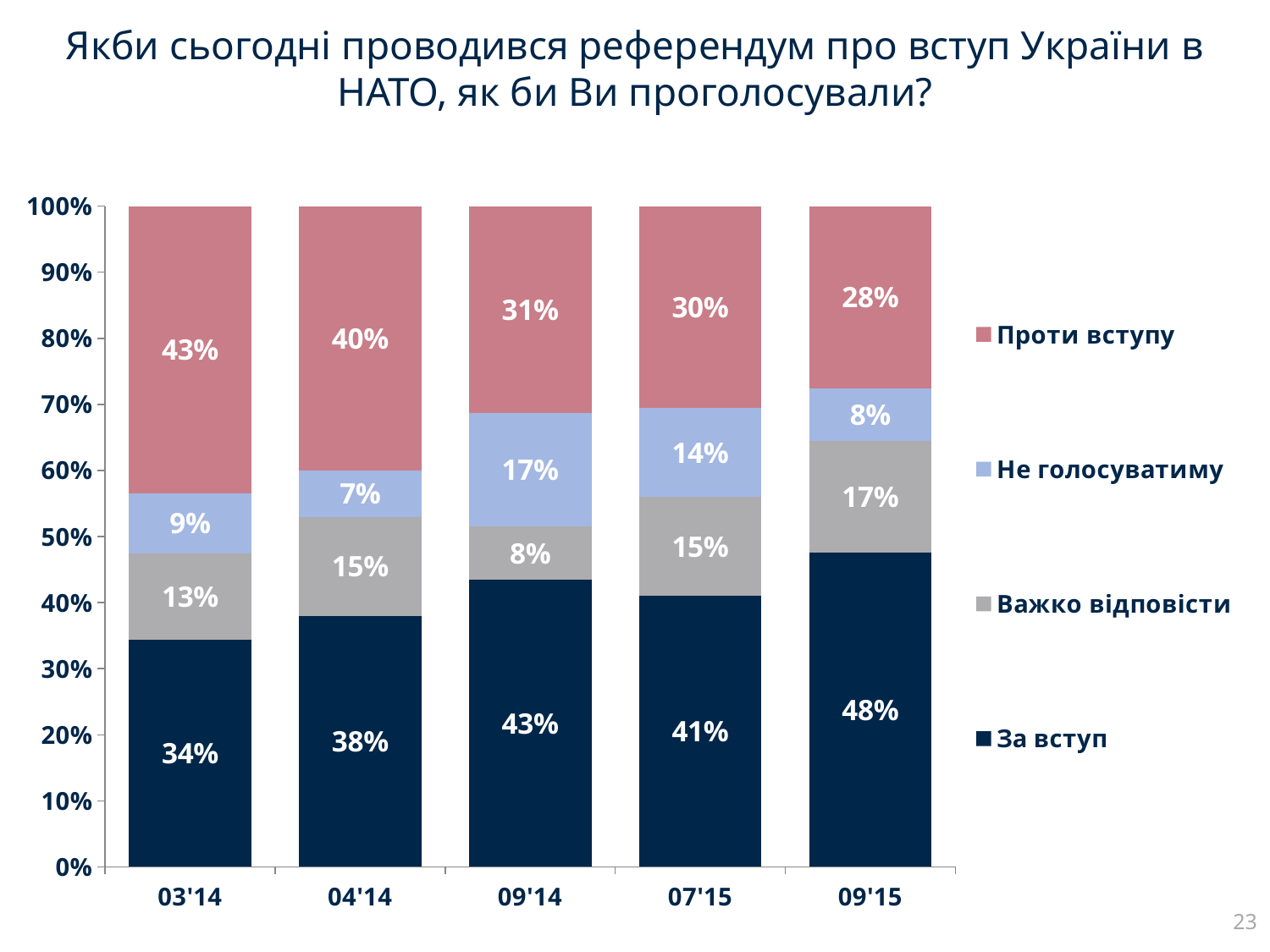
How many time periods are shown on the x axis? 5 Which is larger in 07'15: "За вступ" or "Проти вступу"? За вступ What is the value for "За вступ" in 09'15? 48% In which period is the value for "Проти вступу" lowest? 09'15 How many series does the legend list? 4 What is the value for "Проти вступу" in 03'14? 43% What is the value for "Не голосуватиму" in 09'14? 17% What is the difference between the "За вступ" values in 09'15 and 03'14? 14% What is the value for "Важко відповісти" in 04'14? 15% What kind of chart is shown on the slide? Stacked bar chart Does the value for "Проти вступу" rise or fall from 03'14 to 09'15? Fall In which period is the value for "За вступ" highest? 09'15